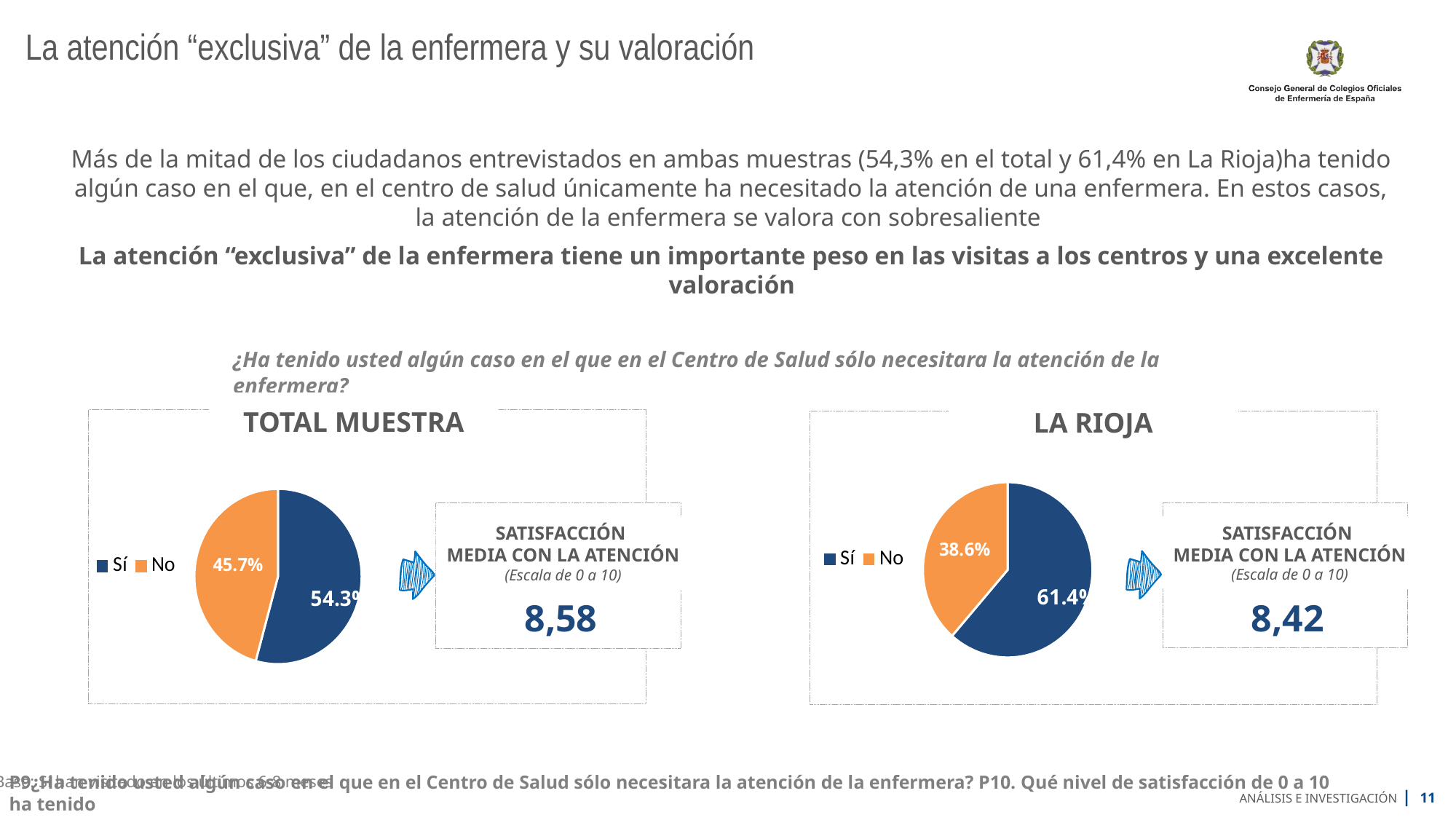
What type of chart is used for TOTAL MUESTRA? Pie chart In the LA RIOJA pie chart, what percentage answered Sí? 61.4% How many categories does the LA RIOJA pie chart show? 2 In the LA RIOJA pie chart, which category has the largest slice? Sí In the LA RIOJA pie chart, what percentage answered No? 38.6% In the TOTAL MUESTRA pie chart, what percentage answered Sí? 54.3% In the TOTAL MUESTRA pie chart, which category has the smallest slice? No Is the Sí share larger in the TOTAL MUESTRA pie chart or in the LA RIOJA pie chart? LA RIOJA In the TOTAL MUESTRA pie chart, what is the difference between the Sí and No percentages? 8.6% In the TOTAL MUESTRA pie chart, which colour represents No? Orange In the LA RIOJA pie chart, what is the difference between the Sí and No percentages? 22.8% In the TOTAL MUESTRA pie chart, what percentage answered No? 45.7%